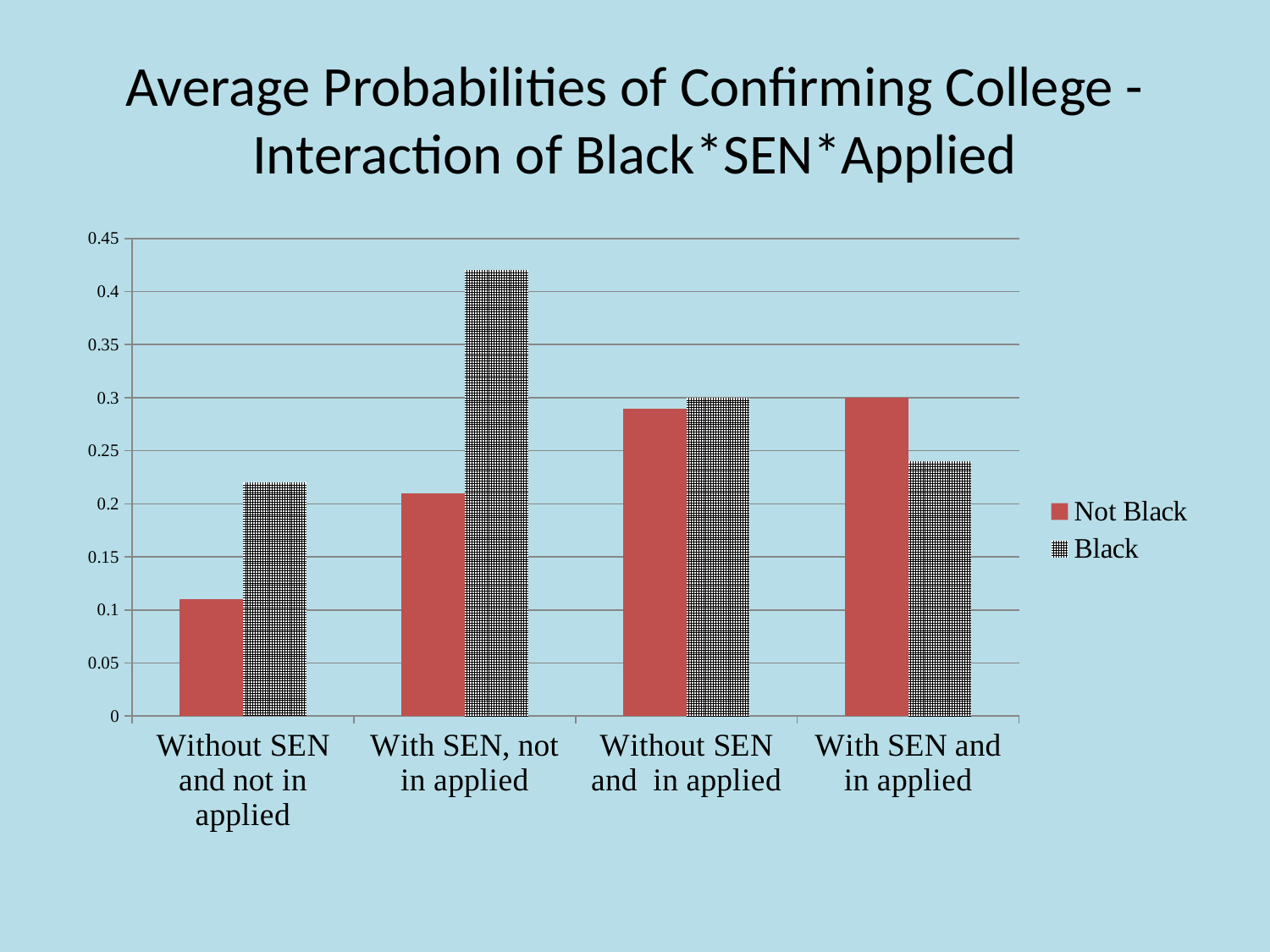
What kind of chart is shown on the slide? bar chart Which category has the lowest Not Black value? Without SEN and not in applied Is the Not Black value for 'Without SEN and not in applied' greater or less than 0.15? less Which category has the highest Black value? With SEN, not in applied Is the Black value for 'Without SEN and not in applied' greater or less than 0.2? greater For 'With SEN and in applied', which is larger, the Not Black value or the Black value? Not Black Is the Black value for 'With SEN, not in applied' greater or less than 0.4? greater How many series does the legend list? 2 How many categories are shown on the x axis? 4 For 'With SEN, not in applied', which is larger, the Not Black value or the Black value? Black Do the Not Black values rise or fall from left to right across the categories? rise